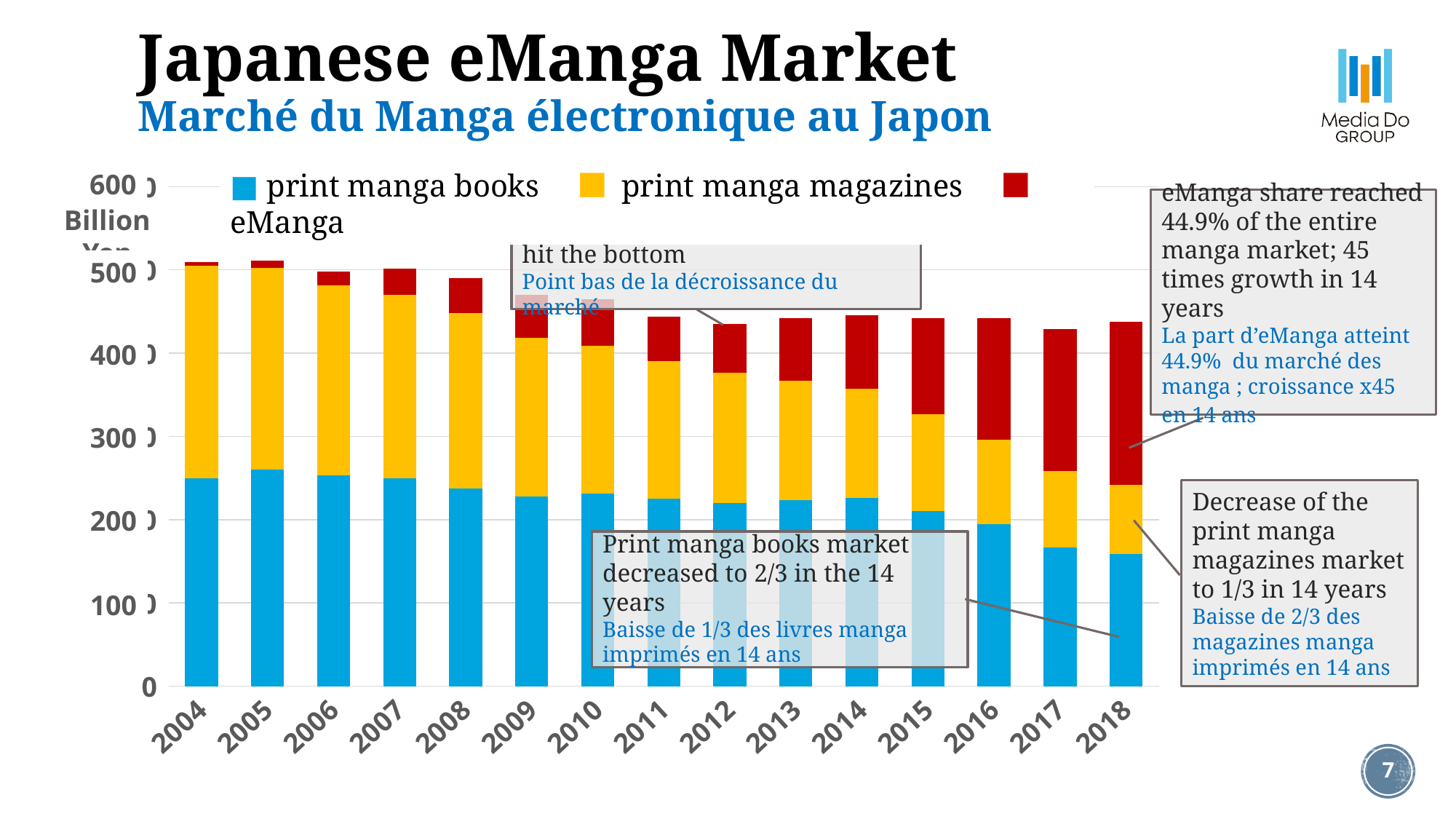
What kind of chart is shown on the slide? stacked bar chart Is the total height of the stacked bar for 2004 greater or less than 500? greater What unit is given for the y axis? Billion Yen Which series is shown in red in the legend? eManga How many years are shown along the x axis? 15 Which series has the largest segment in the 2018 bar? eManga Is the total height of the stacked bar for 2018 greater or less than 500? less Is the value for print manga books in 2018 greater or less than 200? less Does the print manga books series rise or fall from 2004 to 2018? fall Which is larger, the print manga books value in 2004 or in 2018? 2004 How many series does the legend list? 3